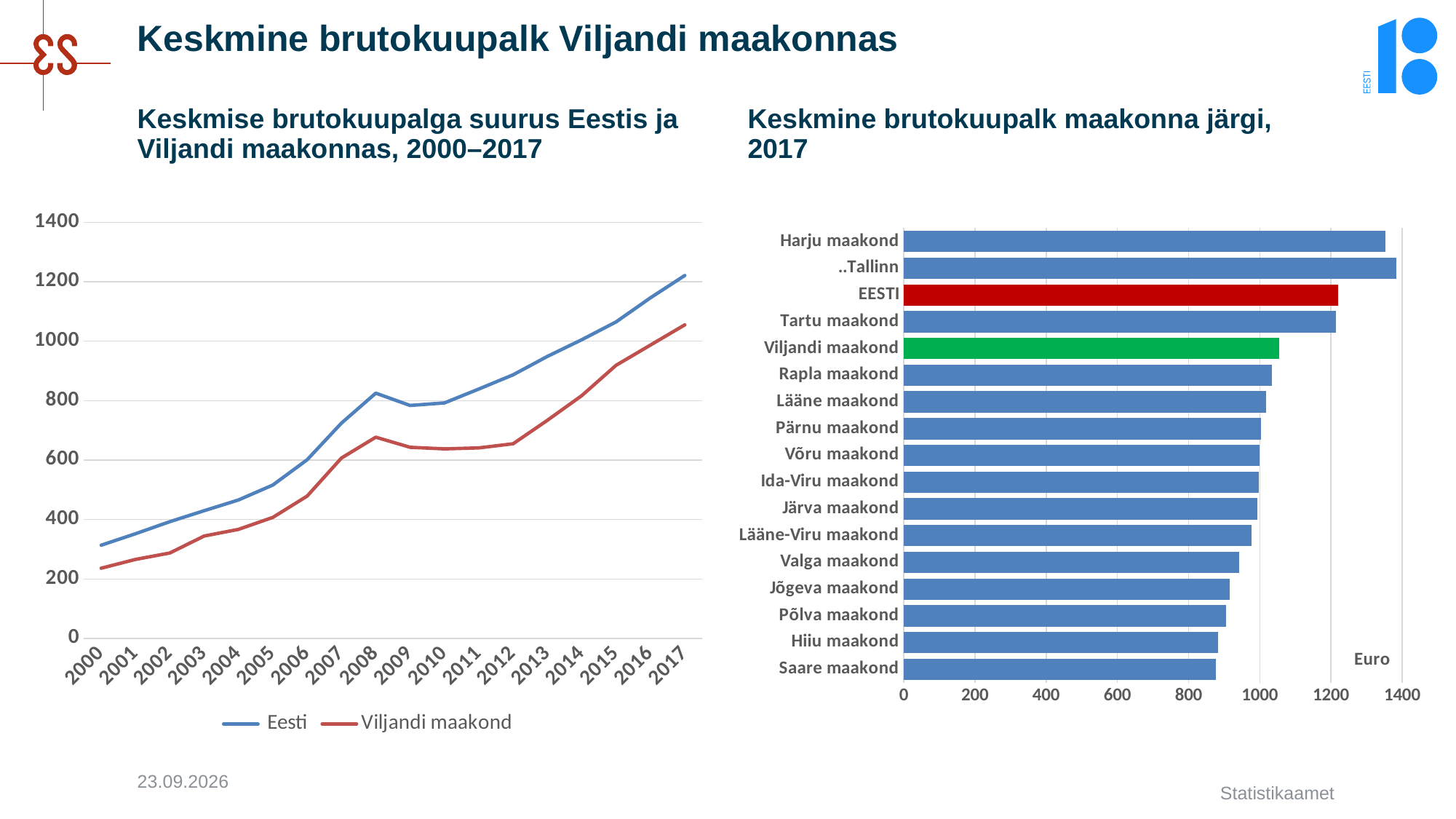
In the right chart, which category has the highest value? ..Tallinn In the right chart, what colour is the bar for Viljandi maakond? green What kind of chart is the right chart, 'Keskmine brutokuupalk maakonna järgi, 2017'? bar chart What kind of chart is the left chart, 'Keskmise brutokuupalga suurus Eestis ja Viljandi maakonnas, 2000–2017'? line chart In the left chart, is the value for Eesti in 2017 greater or less than 1200? greater In the right chart, how many bars are shown? 17 In the left chart, which series is higher in 2010, Eesti or Viljandi maakond? Eesti In the left chart, how many years are plotted on the x axis? 18 In the left chart, do the values for Eesti rise or fall overall from 2000 to 2017? rise In the left chart, how many series does the legend list? 2 In the left chart, is the value for Viljandi maakond in 2017 greater or less than 1000? greater In the right chart, is the value for Saare maakond greater or less than 1000? less